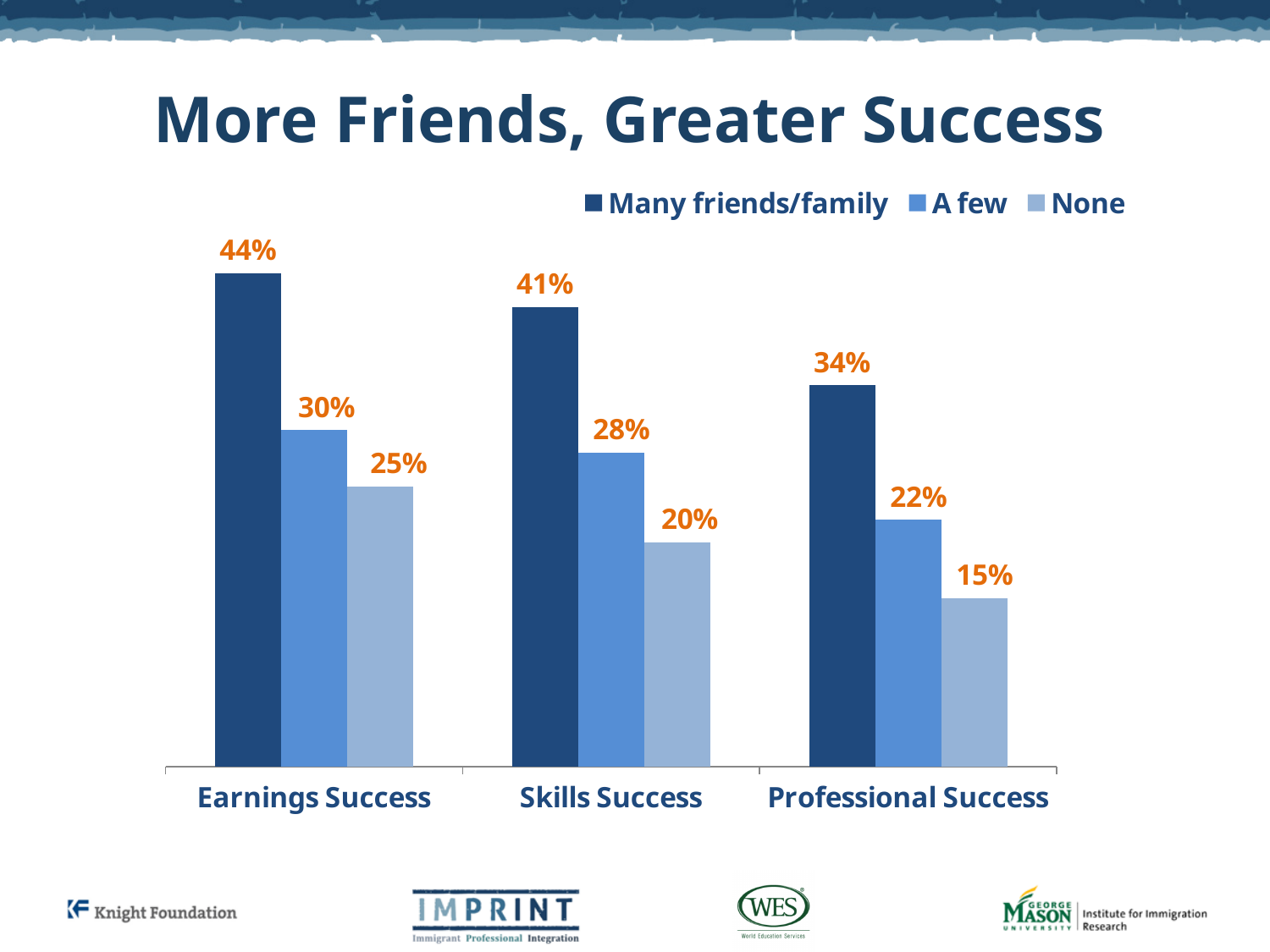
How many series does the legend list? 3 How many categories are shown on the x axis? 3 Within each category, do the values rise or fall from Many friends/family to None? Fall What is the title of the slide? More Friends, Greater Success Which is larger: the A few value for Earnings Success or the A few value for Professional Success? Earnings Success Which category has the lowest value for the None series? Professional Success What is the value for Many friends/family in the Earnings Success category? 44% Which category has the highest value for the Many friends/family series? Earnings Success What is the value for A few in the Skills Success category? 28% What is the value for None in the Professional Success category? 15% What kind of chart is shown on the slide? Bar chart What is the difference between the Many friends/family and None values in the Skills Success category? 21%